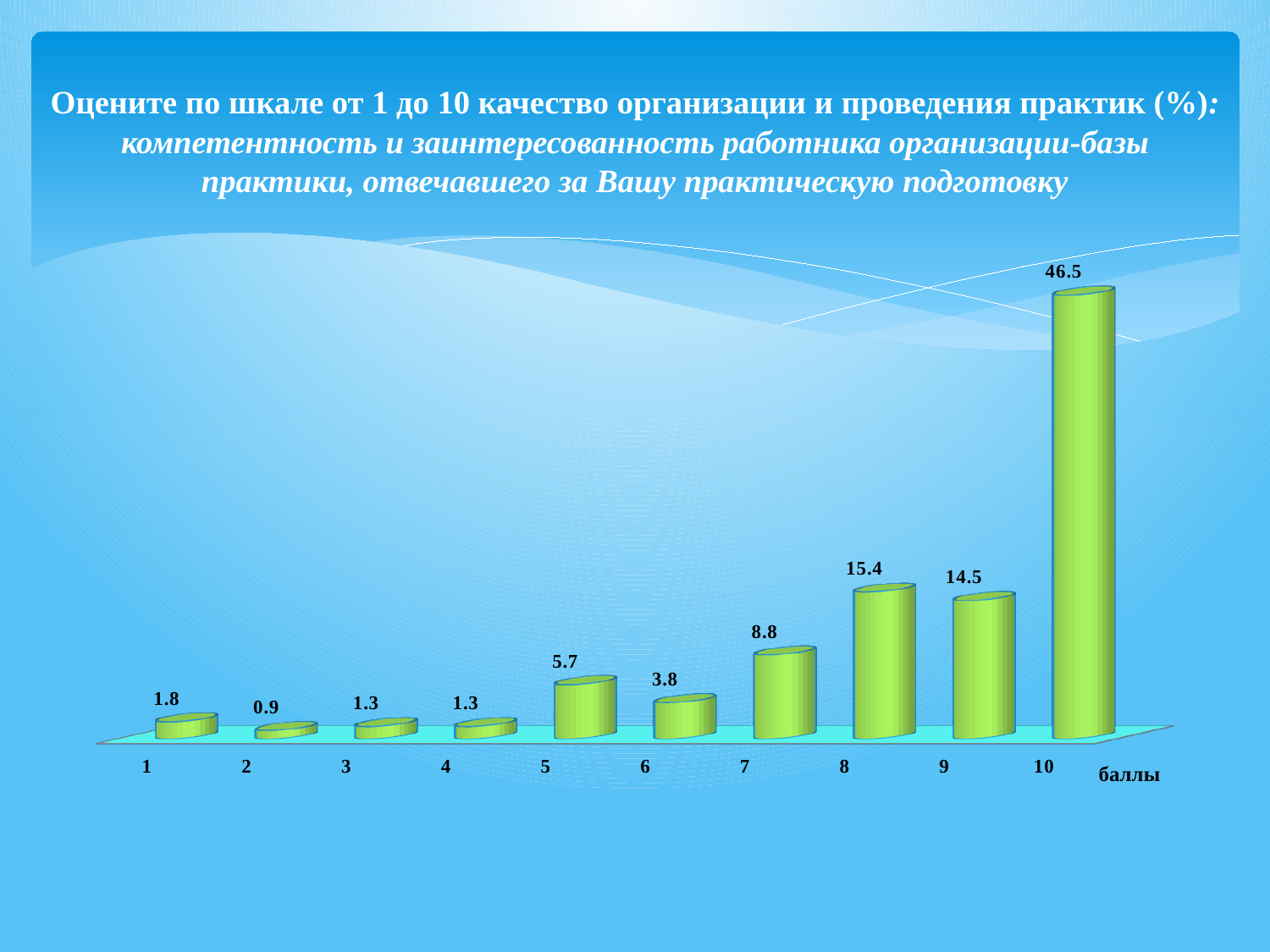
What is the value for score 2? 0.9 Which score has the lowest value? 2 What is the difference between the values for score 10 and score 8? 31.1 How many score categories are shown on the x axis? 10 What colour are the bars in the chart? green What is the value for score 7? 8.8 Which is larger, the value for score 5 or the value for score 6? score 5 What is the value for score 10? 46.5 Which score has the highest value? 10 What is the label of the x axis? баллы What is the difference between the values for score 8 and score 9? 0.9 What kind of chart is shown on the slide? bar chart